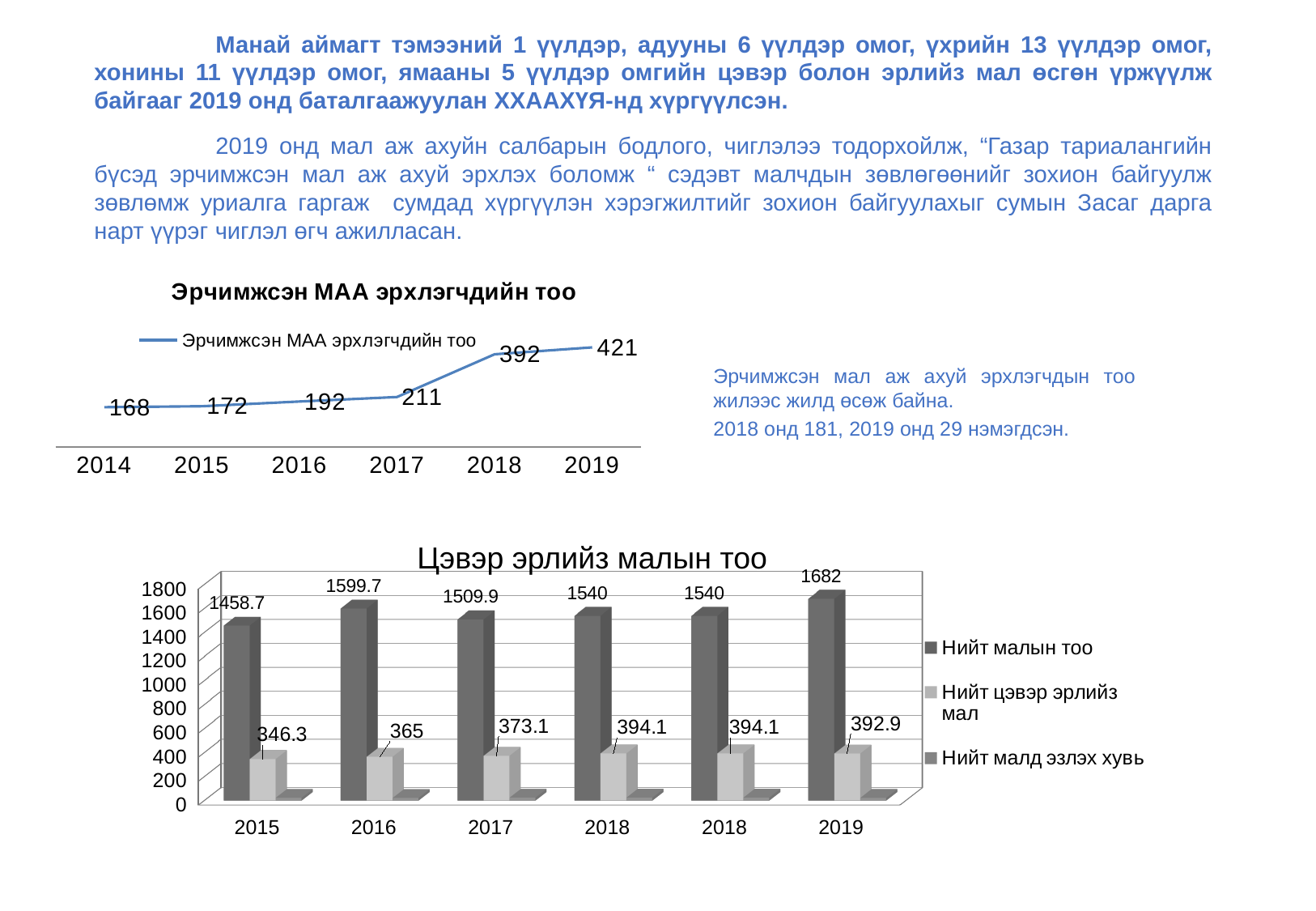
What kind of chart is the chart titled 'Эрчимжсэн МАА эрхлэгчдийн тоо'? line chart In the chart titled 'Цэвэр эрлийз малын тоо', which year has the highest value for 'Нийт малын тоо'? 2019 In the chart titled 'Цэвэр эрлийз малын тоо', what is the value of 'Нийт малын тоо' for 2016? 1599.7 How many series does the legend of the chart titled 'Цэвэр эрлийз малын тоо' list? 3 In the chart titled 'Эрчимжсэн МАА эрхлэгчдийн тоо', do the values rise or fall from 2014 to 2019? rise What kind of chart is the chart titled 'Цэвэр эрлийз малын тоо'? bar chart In the chart titled 'Цэвэр эрлийз малын тоо', what is the value of 'Нийт цэвэр эрлийз мал' for 2015? 346.3 In the chart titled 'Эрчимжсэн МАА эрхлэгчдийн тоо', what is the value for 2017? 211 In the chart titled 'Эрчимжсэн МАА эрхлэгчдийн тоо', which year has the highest value? 2019 In the chart titled 'Эрчимжсэн МАА эрхлэгчдийн тоо', which year has the lowest value? 2014 In the chart titled 'Эрчимжсэн МАА эрхлэгчдийн тоо', what is the difference between the values for 2018 and 2017? 181 In the chart titled 'Цэвэр эрлийз малын тоо', is the value of 'Нийт малын тоо' for 2019 greater or less than 1600? greater